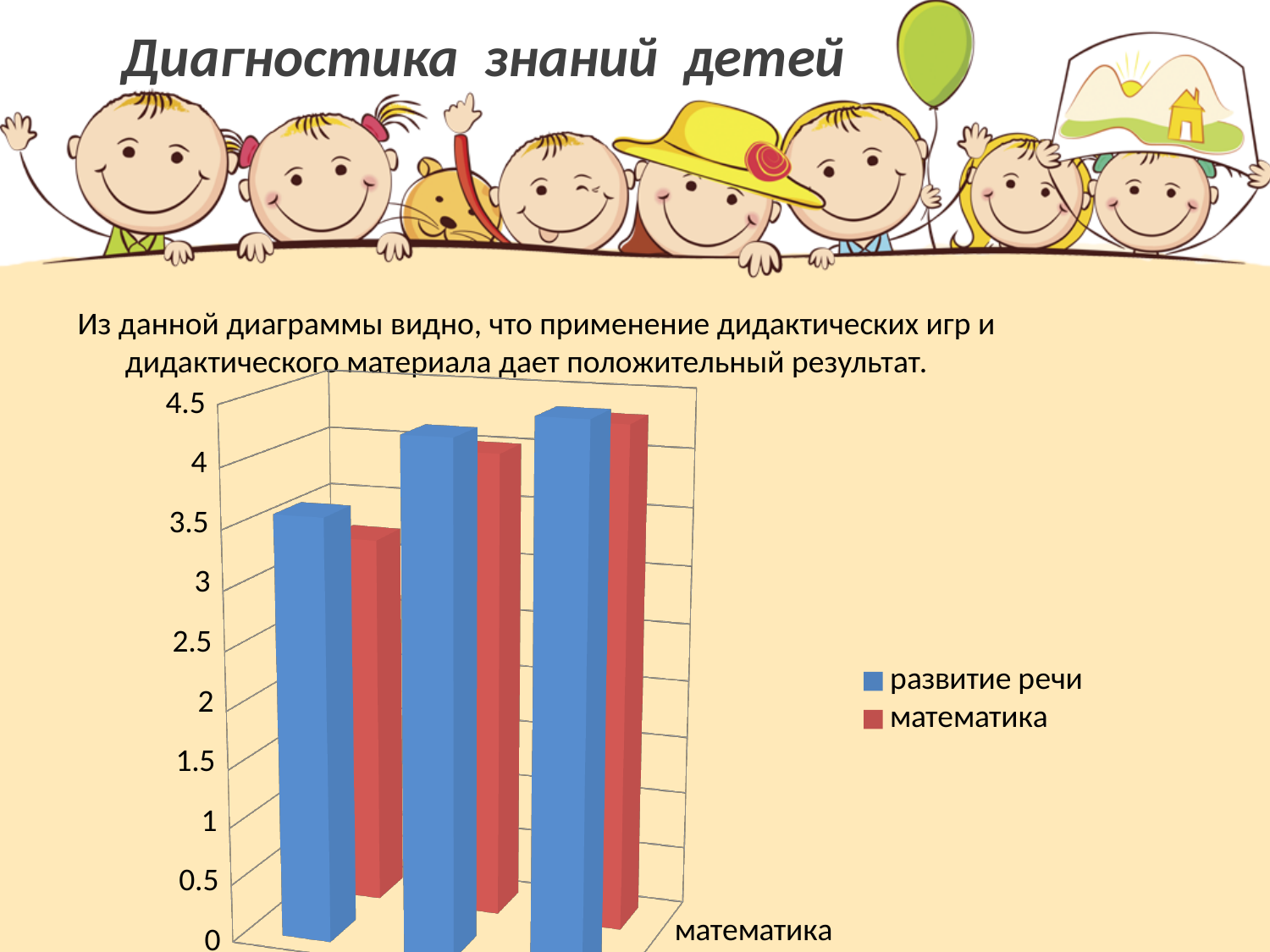
Do the values for 'математика' rise or fall from left to right across the groups? rise Which bar in the chart is the tallest? the 'развитие речи' bar in the third group How many series does the chart legend list? 2 What are the two series named in the chart legend? развитие речи, математика Which colour represents the series 'развитие речи' in the chart? blue How many groups of bars are plotted in the chart? 3 Is the value of the third 'развитие речи' bar greater or less than 4? greater What kind of chart is shown on the slide? bar chart Do the values for 'развитие речи' rise or fall from the first group of bars to the third? rise Is the value of the first 'математика' bar greater or less than 3? greater Is the value of the first 'развитие речи' bar greater or less than 4? less In the first group of bars, which series has the larger value, 'развитие речи' or 'математика'? развитие речи